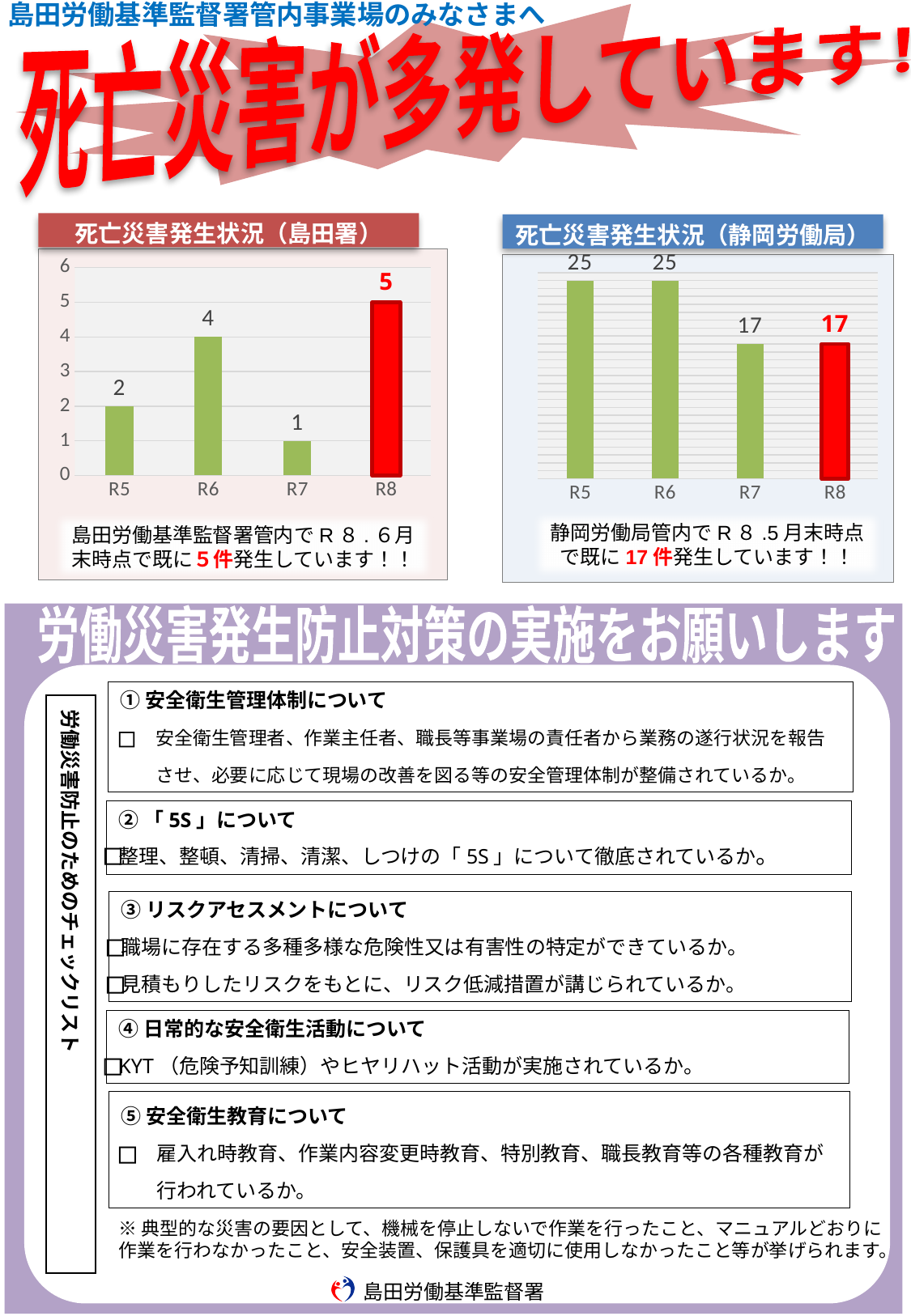
In the 死亡災害発生状況（静岡労働局） chart, what is the difference between the values for R6 and R7? 8 In the 死亡災害発生状況（静岡労働局） chart, what is the value for R5? 25 In the 死亡災害発生状況（島田署） chart, how many years are shown on the x axis? 4 In the 死亡災害発生状況（島田署） chart, what is the value for R7? 1 In the 死亡災害発生状況（静岡労働局） chart, which bar is coloured red? R8 In the 死亡災害発生状況（静岡労働局） chart, what is the value for R8? 17 In the 死亡災害発生状況（静岡労働局） chart, is the value for R5 larger or smaller than the value for R7? larger What kind of chart is the 死亡災害発生状況（静岡労働局） chart? bar chart In the 死亡災害発生状況（島田署） chart, what is the value for R8? 5 In the 死亡災害発生状況（島田署） chart, what is the difference between the values for R8 and R6? 1 In the 死亡災害発生状況（島田署） chart, which year has the highest value? R8 In the 死亡災害発生状況（島田署） chart, which year has the lowest value? R7